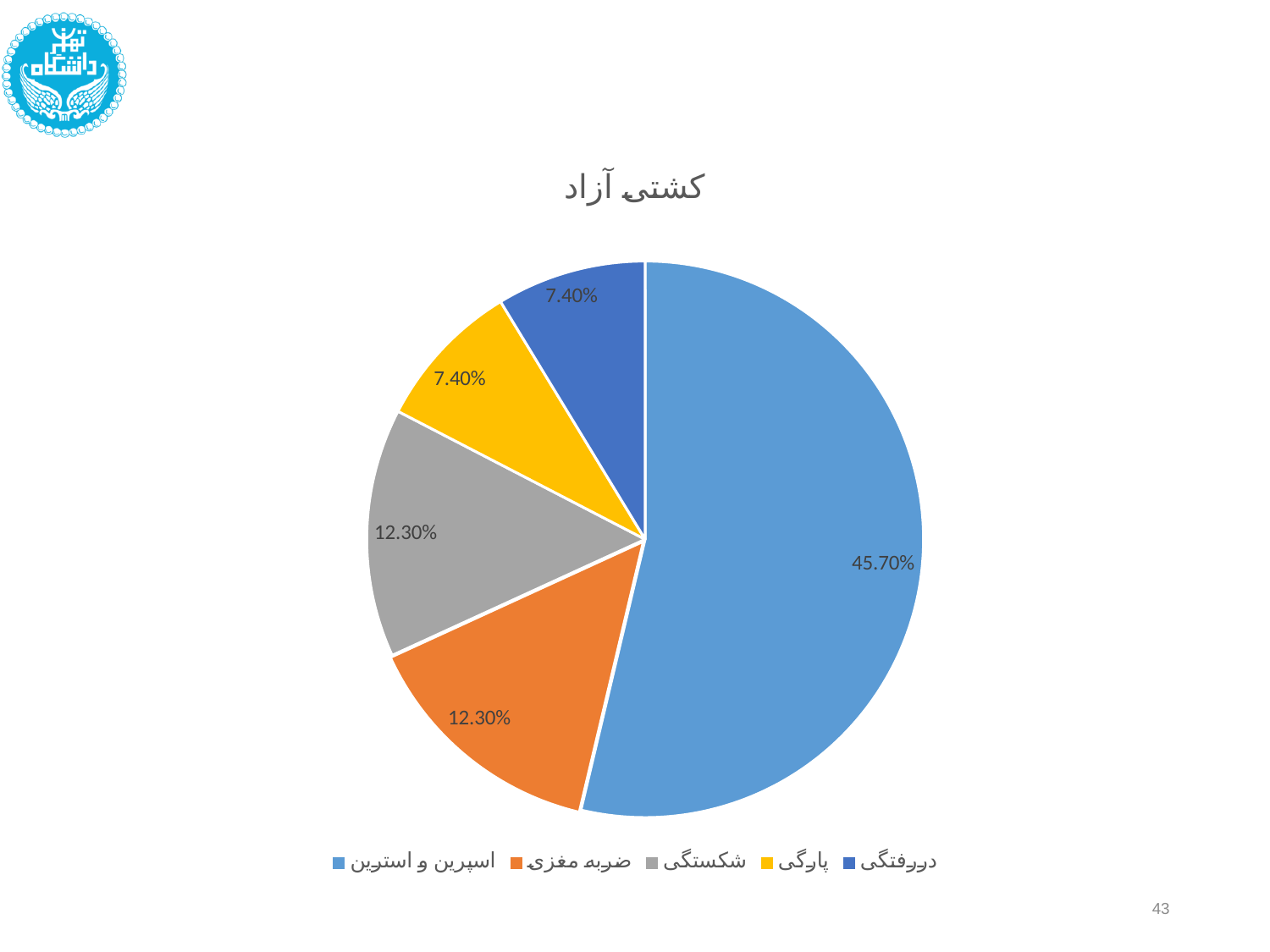
How many categories does the pie chart have? 5 What percentage is shown for ضربه مغزی? 12.30% Which is larger, the slice for شکستگی or the slice for پارگی? شکستگی What percentage of the pie is the slice for اسپرین و استرین? 45.70% What is the difference in percentage points between اسپرین و استرین and ضربه مغزی? 33.40% What percentage is shown for پارگی? 7.40% What percentage is shown for دررفتگی? 7.40% What is the title of the chart? کشتی آزاد What colour is the slice for پارگی? yellow What kind of chart is shown on the slide? pie chart What percentage is shown for شکستگی? 12.30% Which category has the largest slice of the pie? اسپرین و استرین